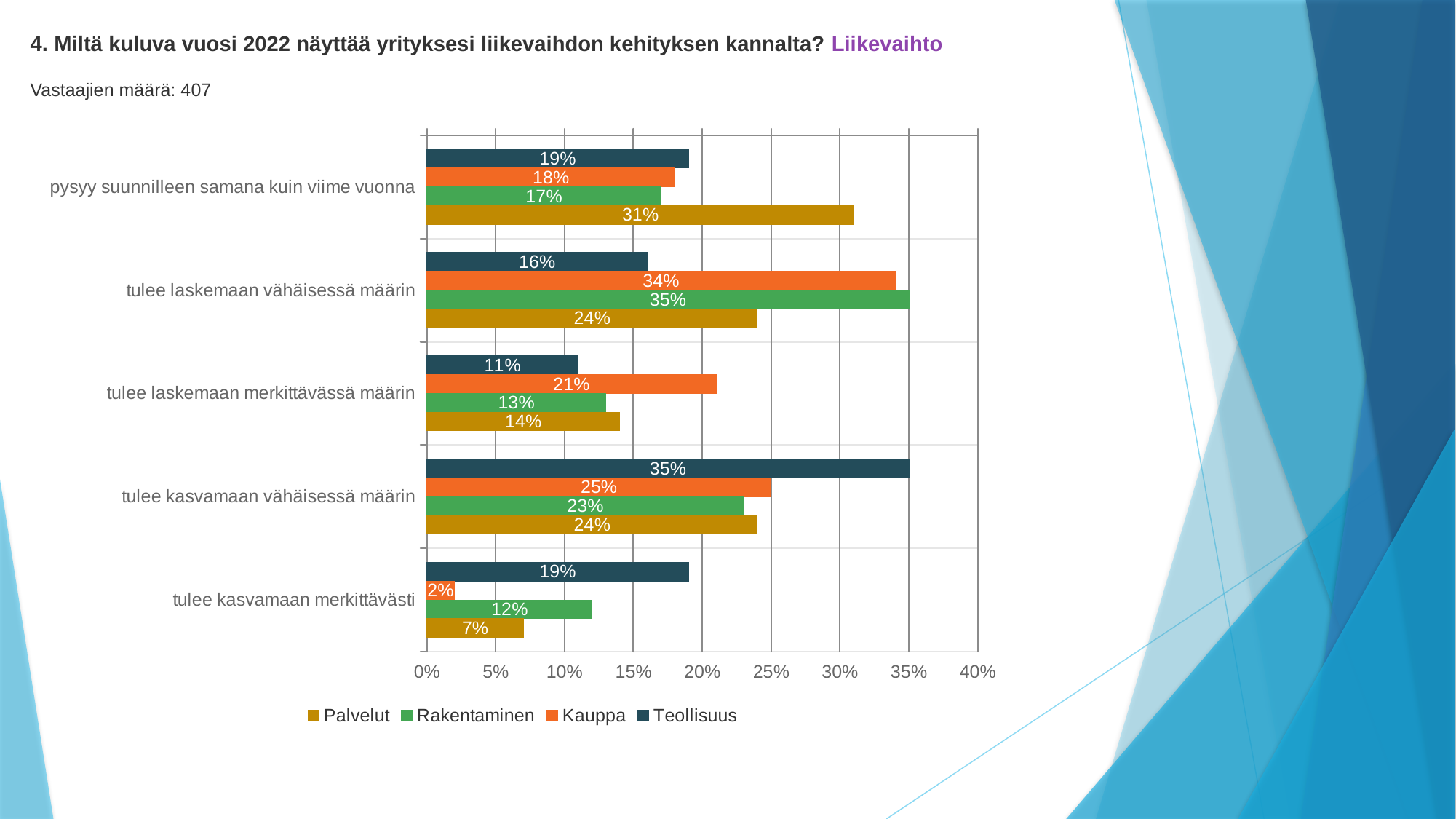
What is the difference between the Kauppa and Teollisuus values in the category 'tulee laskemaan vähäisessä määrin'? 18% Which legend entry is shown in orange? Kauppa Is the value for Teollisuus in the category 'tulee kasvamaan vähäisessä määrin' greater or less than 30%? greater Which series has the lowest value in the category 'tulee laskemaan merkittävässä määrin'? Teollisuus What is the value for Rakentaminen in the category 'tulee laskemaan vähäisessä määrin'? 35% What is the value for Palvelut in the category 'pysyy suunnilleen samana kuin viime vuonna'? 31% What is the value for Kauppa in the category 'tulee kasvamaan merkittävästi'? 2% How many categories are shown on the vertical axis of the chart? 5 What kind of chart is shown on the slide? bar chart How many series does the legend list? 4 Which series has the highest value in the category 'tulee kasvamaan vähäisessä määrin'? Teollisuus In the category 'tulee kasvamaan merkittävästi', which is larger: the value for Rakentaminen or the value for Palvelut? Rakentaminen